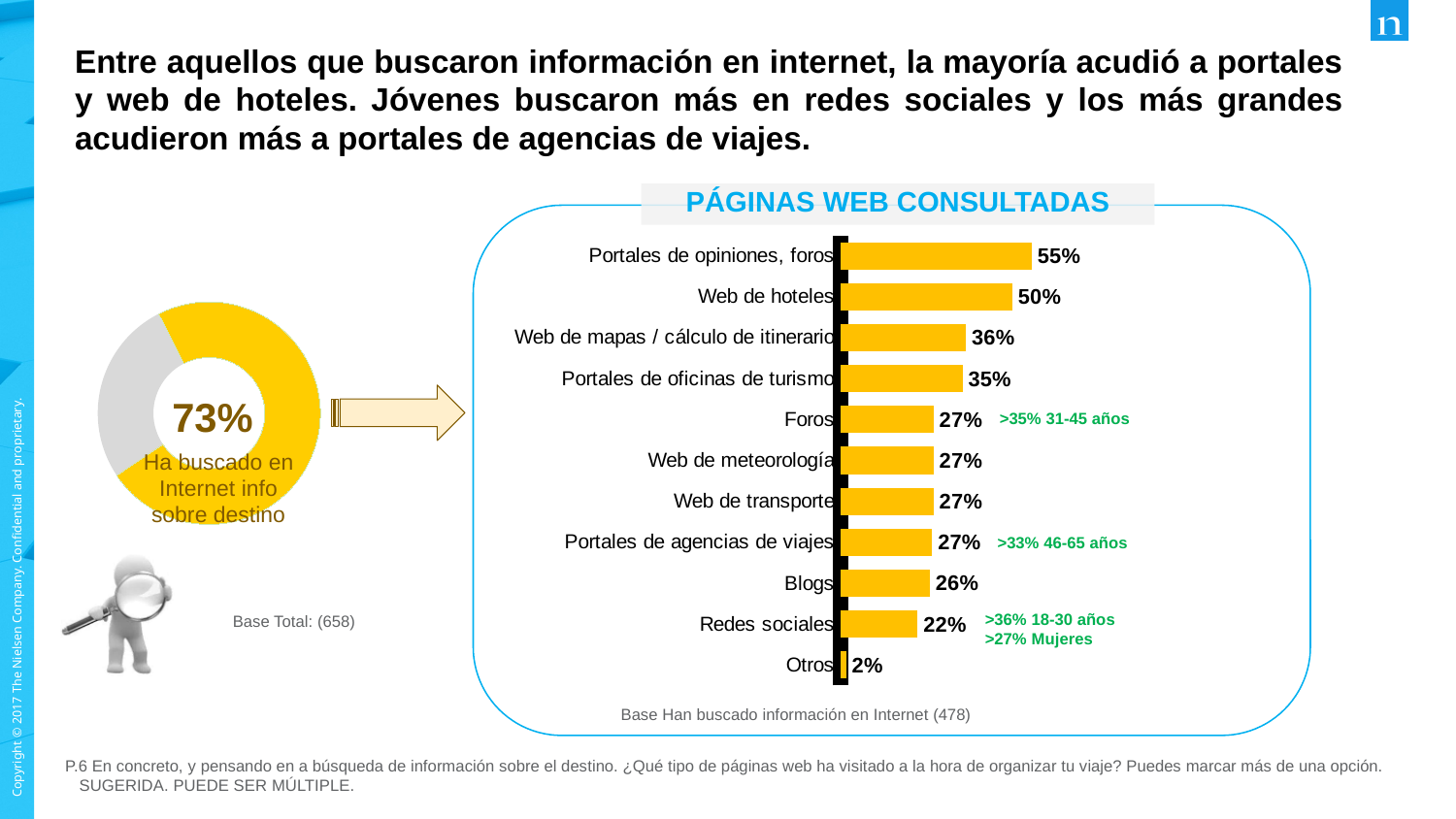
In the 'PÁGINAS WEB CONSULTADAS' bar chart, which is larger: 'Web de mapas / cálculo de itinerario' or 'Redes sociales'? Web de mapas / cálculo de itinerario In the 'PÁGINAS WEB CONSULTADAS' bar chart, what is the value for 'Web de mapas / cálculo de itinerario'? 36% How many categories are shown in the 'PÁGINAS WEB CONSULTADAS' bar chart? 11 In the 'PÁGINAS WEB CONSULTADAS' bar chart, what is the difference between 'Portales de oficinas de turismo' and 'Blogs'? 9% In the 'PÁGINAS WEB CONSULTADAS' bar chart, which category has the highest value? Portales de opiniones, foros What kind of chart is 'PÁGINAS WEB CONSULTADAS'? Bar chart In the 'PÁGINAS WEB CONSULTADAS' bar chart, what is the difference between 'Portales de opiniones, foros' and 'Web de hoteles'? 5% In the 'PÁGINAS WEB CONSULTADAS' bar chart, what is the value for 'Redes sociales'? 22% In the 'PÁGINAS WEB CONSULTADAS' bar chart, which category has the lowest value? Otros What is the base shown below the 'PÁGINAS WEB CONSULTADAS' bar chart? Base Han buscado información en Internet (478) In the 'PÁGINAS WEB CONSULTADAS' bar chart, what is the value for 'Web de hoteles'? 50% In the donut chart on the left of the slide, what percentage has searched for destination information on the Internet? 73%